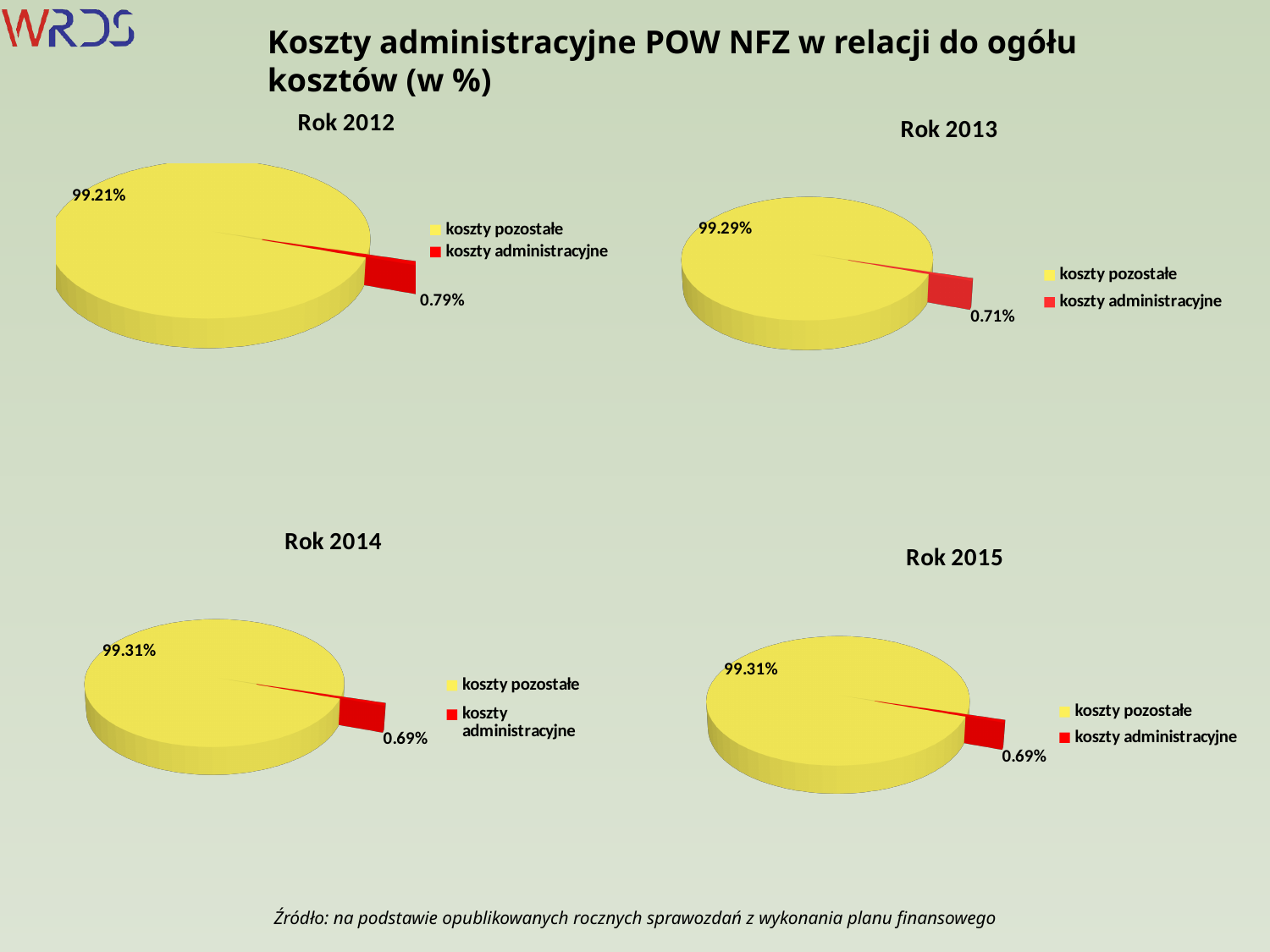
In the Rok 2015 chart, what is the value for koszty pozostałe? 99.31% In the Rok 2012 chart, what is the value for koszty administracyjne? 0.79% What kind of chart is the Rok 2014 chart? pie chart In the Rok 2013 chart, what colour is the koszty administracyjne slice? red Is the value for koszty administracyjne in the Rok 2012 chart larger or smaller than in the Rok 2013 chart? larger In the Rok 2012 chart, which slice is the largest? koszty pozostałe In the Rok 2013 chart, which slice is the smallest? koszty administracyjne In the Rok 2014 chart, what is the value for koszty administracyjne? 0.69% In the Rok 2013 chart, what is the value for koszty pozostałe? 99.29% How many slices does the Rok 2015 chart have? 2 What is the difference between the koszty administracyjne values in the Rok 2012 chart and the Rok 2015 chart? 0.10% How many entries does the legend of the Rok 2012 chart list? 2